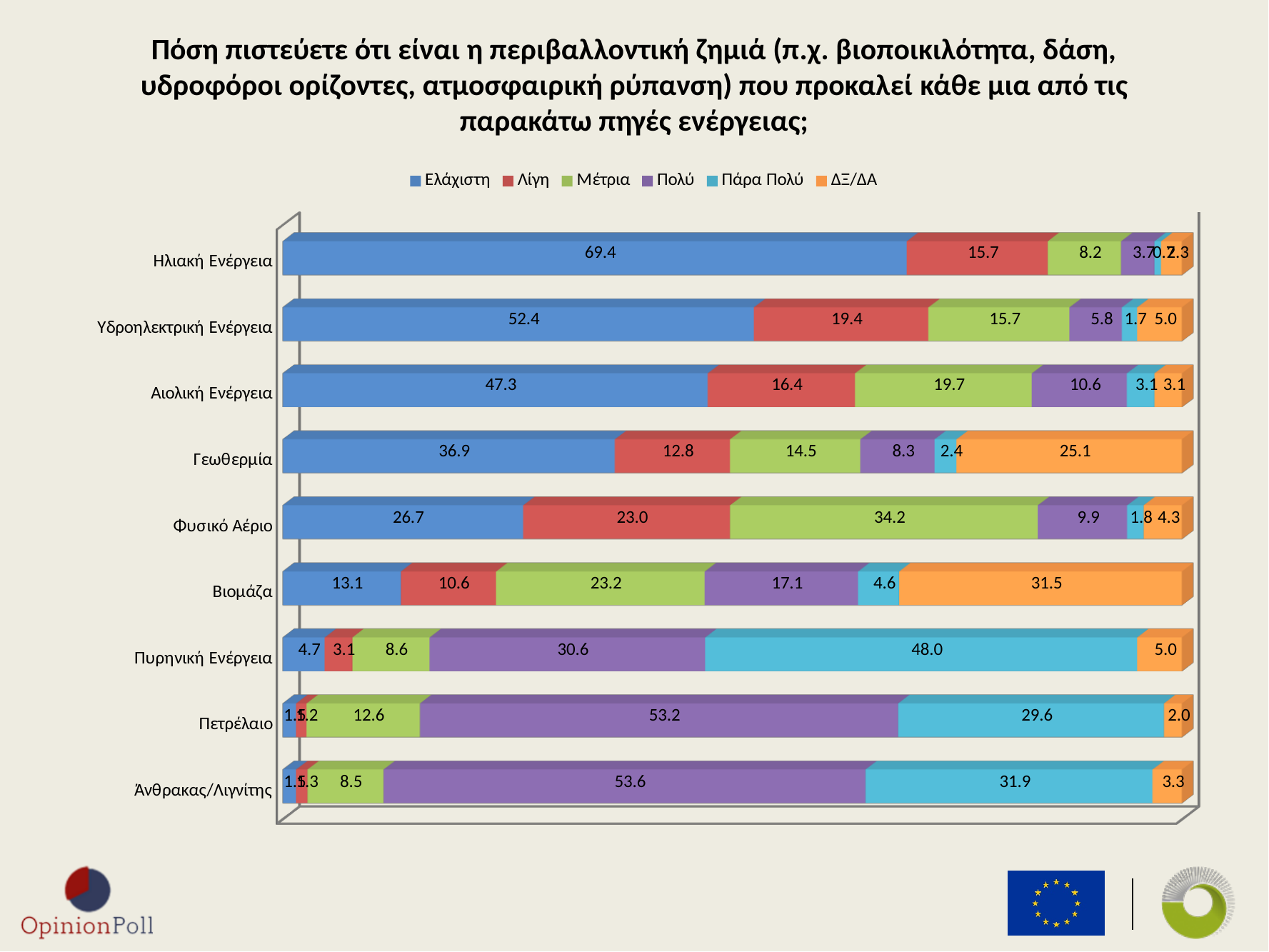
What is the Μέτρια value for Φυσικό Αέριο? 34.2 Which energy source has the highest Ελάχιστη value? Ηλιακή Ενέργεια What kind of chart is shown on the slide? stacked bar chart What is the Ελάχιστη value for Ηλιακή Ενέργεια? 69.4 What is the ΔΞ/ΔΑ value for Βιομάζα? 31.5 What is the Πάρα Πολύ value for Πυρηνική Ενέργεια? 48.0 How many energy sources (categories) are shown on the chart? 9 Which is larger: the ΔΞ/ΔΑ value for Γεωθερμία or for Βιομάζα? Βιομάζα Which energy source has the lowest Πολύ value? Ηλιακή Ενέργεια Which colour represents the Πάρα Πολύ series in the legend? light blue How many series does the legend list? 6 What is the difference between the Πολύ values for Άνθρακας/Λιγνίτης and Πετρέλαιο? 0.4